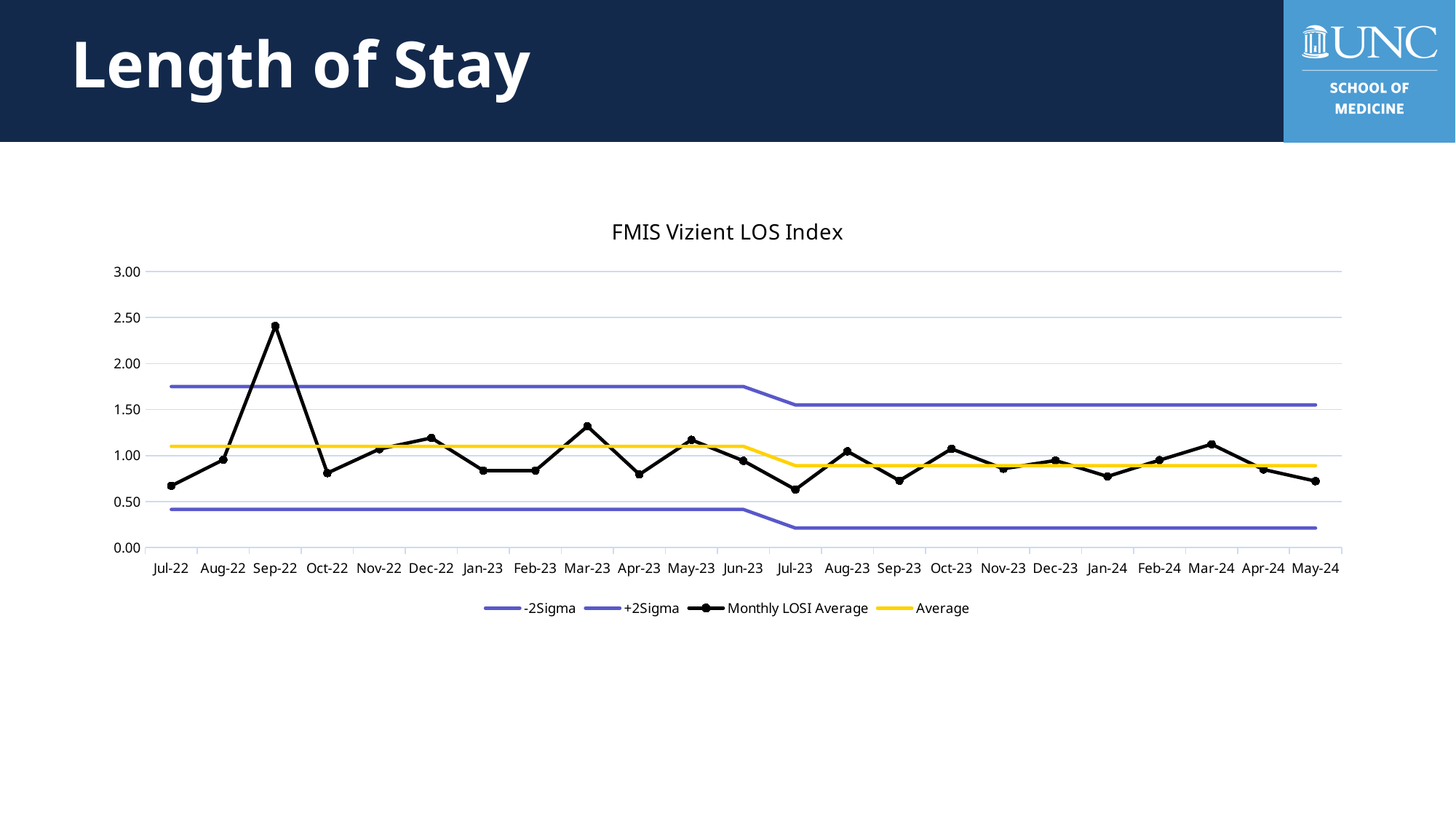
How many months are plotted along the x axis? 23 Is the Monthly LOSI Average for Oct-22 greater or less than 1.00? less In which month is the Monthly LOSI Average highest? Sep-22 Is the Monthly LOSI Average for Sep-22 greater or less than 2.00? greater Does the Monthly LOSI Average rise or fall from Sep-22 to Oct-22? fall Which is larger, the Monthly LOSI Average for Sep-22 or for Mar-23? Sep-22 What is the title of the chart? FMIS Vizient LOS Index How many series does the legend list? 4 Is the Monthly LOSI Average for Mar-23 greater or less than 1.00? greater What kind of chart is shown on the slide? line chart What colour is the Average line in the chart? yellow